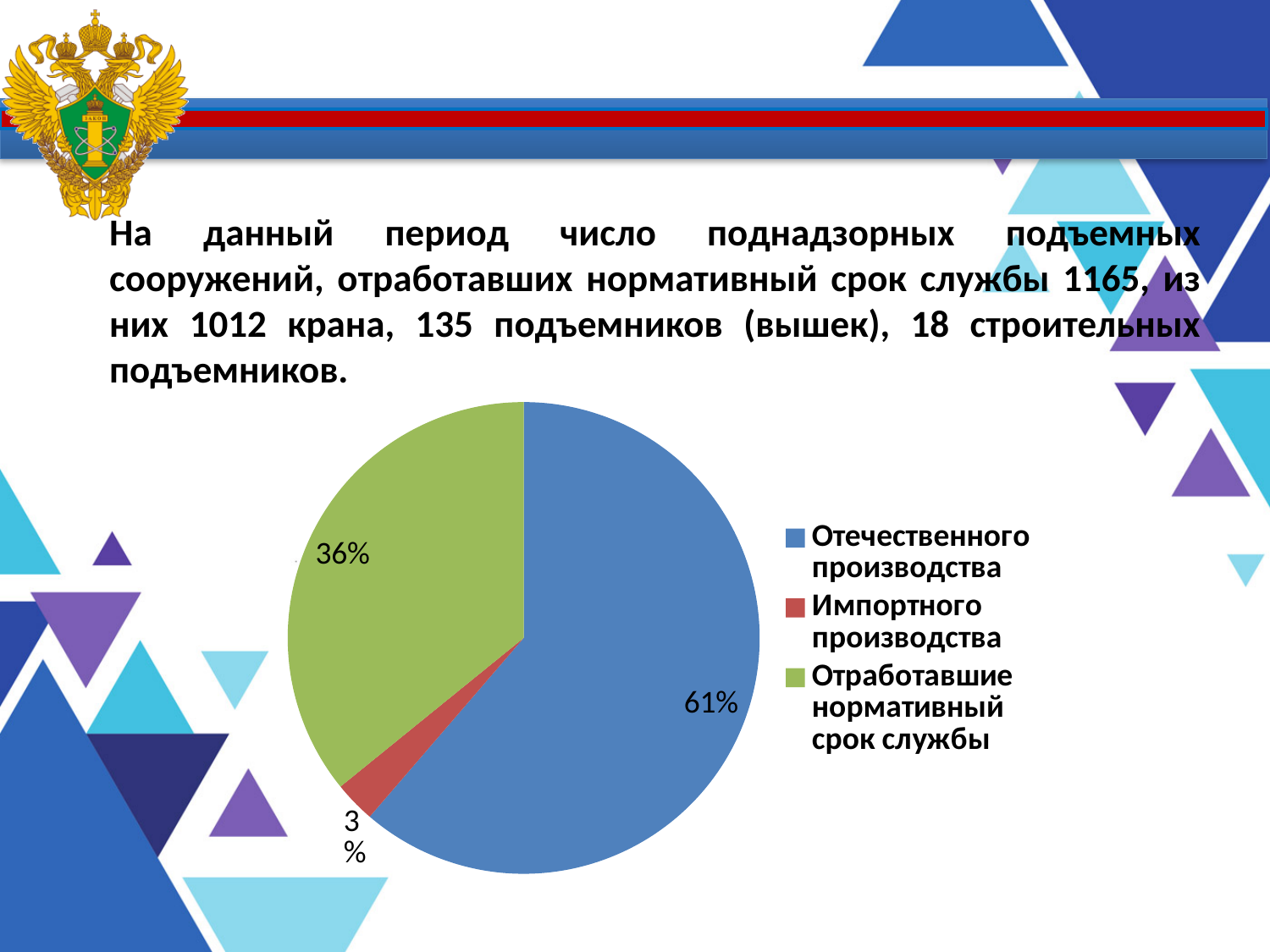
What is the difference in percentage points between the "Отечественного производства" slice and the "Отработавшие нормативный срок службы" slice? 25 What share of the pie is labelled "Отработавшие нормативный срок службы"? 36% Which is larger: the "Отработавшие нормативный срок службы" slice or the "Импортного производства" slice? Отработавшие нормативный срок службы Which slice of the pie chart is the largest? Отечественного производства Which slice of the pie chart is the smallest? Импортного производства What colour is the "Отработавшие нормативный срок службы" slice in the pie chart? green How many entries does the legend of the pie chart list? 3 What kind of chart is shown on the slide? pie chart How many slices does the pie chart have? 3 What colour is the "Импортного производства" slice in the pie chart? red What share of the pie is labelled "Импортного производства"? 3% What share of the pie is labelled "Отечественного производства"? 61%